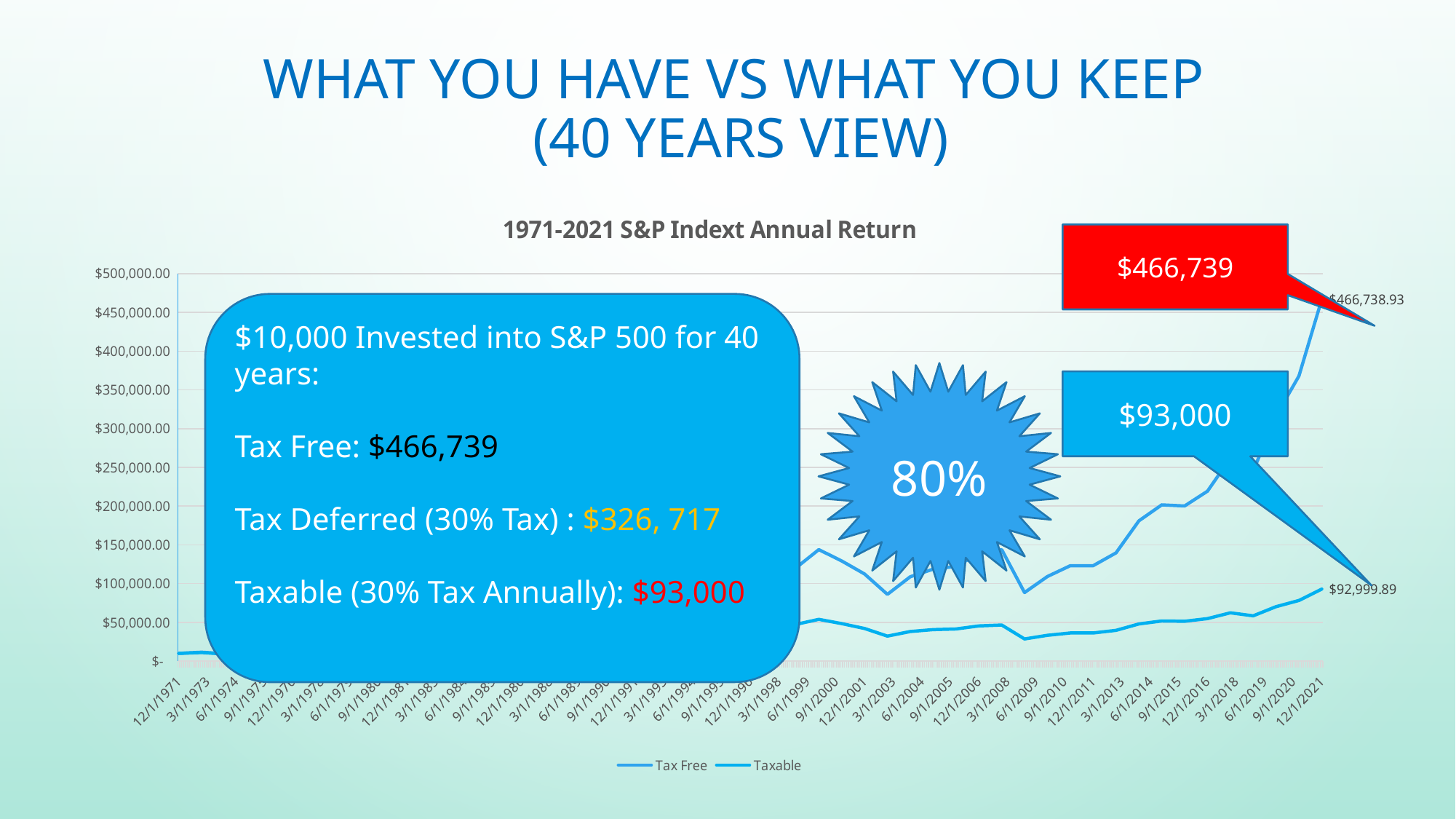
What is the data-labelled value of the Taxable series at 12/1/2021? $92,999.89 What is the title of the chart? 1971-2021 S&P Indext Annual Return Is the value of the Tax Free series at 9/1/2015 greater or less than $150,000.00? greater Which series has the larger value at 12/1/2021, Tax Free or Taxable? Tax Free What are the two series named in the chart's legend? Tax Free and Taxable What kind of chart is shown on the slide? line chart What is the difference between the Tax Free and Taxable values at 12/1/2021? $373,739.04 How many series does the chart's legend list? 2 What is the data-labelled value of the Tax Free series at 12/1/2021? $466,738.93 Is the value of the Taxable series at 12/1/2021 greater or less than $100,000.00? less Does the Tax Free series overall rise or fall from 12/1/1971 to 12/1/2021? rise Is the value of the Tax Free series at 12/1/2021 greater or less than $450,000.00? greater